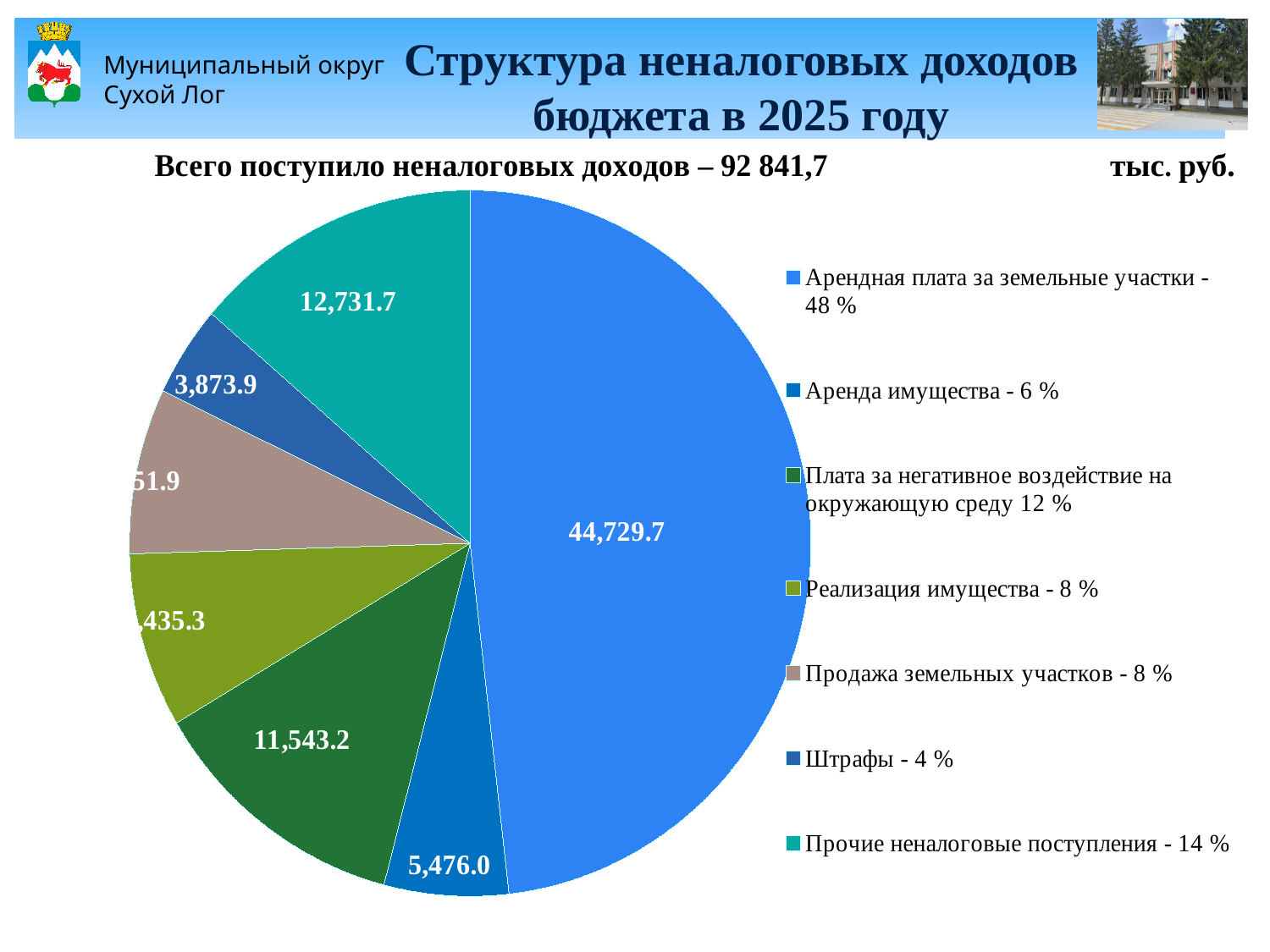
Which is larger: the value for Штрафы or the value for Аренда имущества? Аренда имущества How many slices does the pie chart have? 7 Which category has the largest slice of the pie? Арендная плата за земельные участки What is the value shown for Арендная плата за земельные участки? 44,729.7 What is the value shown for Прочие неналоговые поступления? 12,731.7 What kind of chart is shown on the slide? pie chart What is the value shown for Штрафы? 3,873.9 Which category has the smallest slice of the pie? Штрафы What is the value shown for Аренда имущества? 5,476.0 What is the value shown for Плата за негативное воздействие на окружающую среду? 11,543.2 What share of the pie does Прочие неналоговые поступления represent, according to the legend? 14 % What is the difference between the values for Прочие неналоговые поступления and Плата за негативное воздействие на окружающую среду? 1,188.5